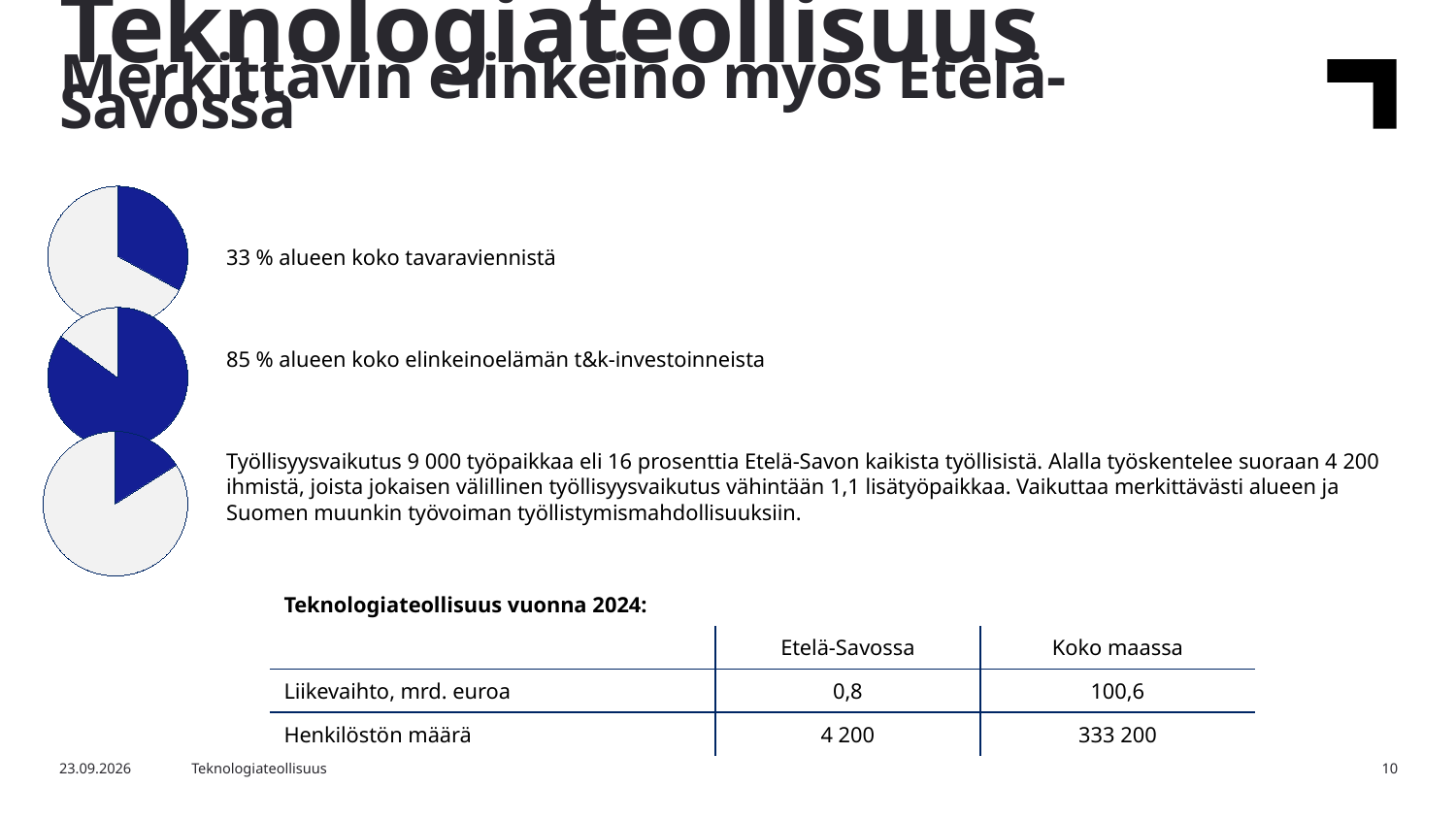
What is the difference in percentage points between the blue slice of the middle pie chart and the blue slice of the top pie chart? 52 percentage points What two colours are used for the slices in the pie charts? Dark blue and light grey How many pie charts are shown on the slide? 3 Is the blue slice in the top pie chart larger or smaller than the blue slice in the middle pie chart? Smaller Which of the three pie charts has the largest blue slice? The middle pie chart (85 %) In the top pie chart, what share of the region's total goods exports does the blue slice represent, according to the text beside it? 33 % In the middle pie chart, what share of the region's business R&D investments does the blue slice represent, according to the text beside it? 85 % Which of the three pie charts has the smallest blue slice? The bottom pie chart (16 prosenttia) In the top pie chart, is the blue slice greater or less than 50 % of the pie? less In the middle pie chart, is the blue slice greater or less than 50 % of the pie? greater In the bottom pie chart, what share of all employed people in Etelä-Savo does the blue slice represent, according to the text beside it? 16 prosenttia What kind of chart is used for the three graphics on the left side of the slide? Pie chart